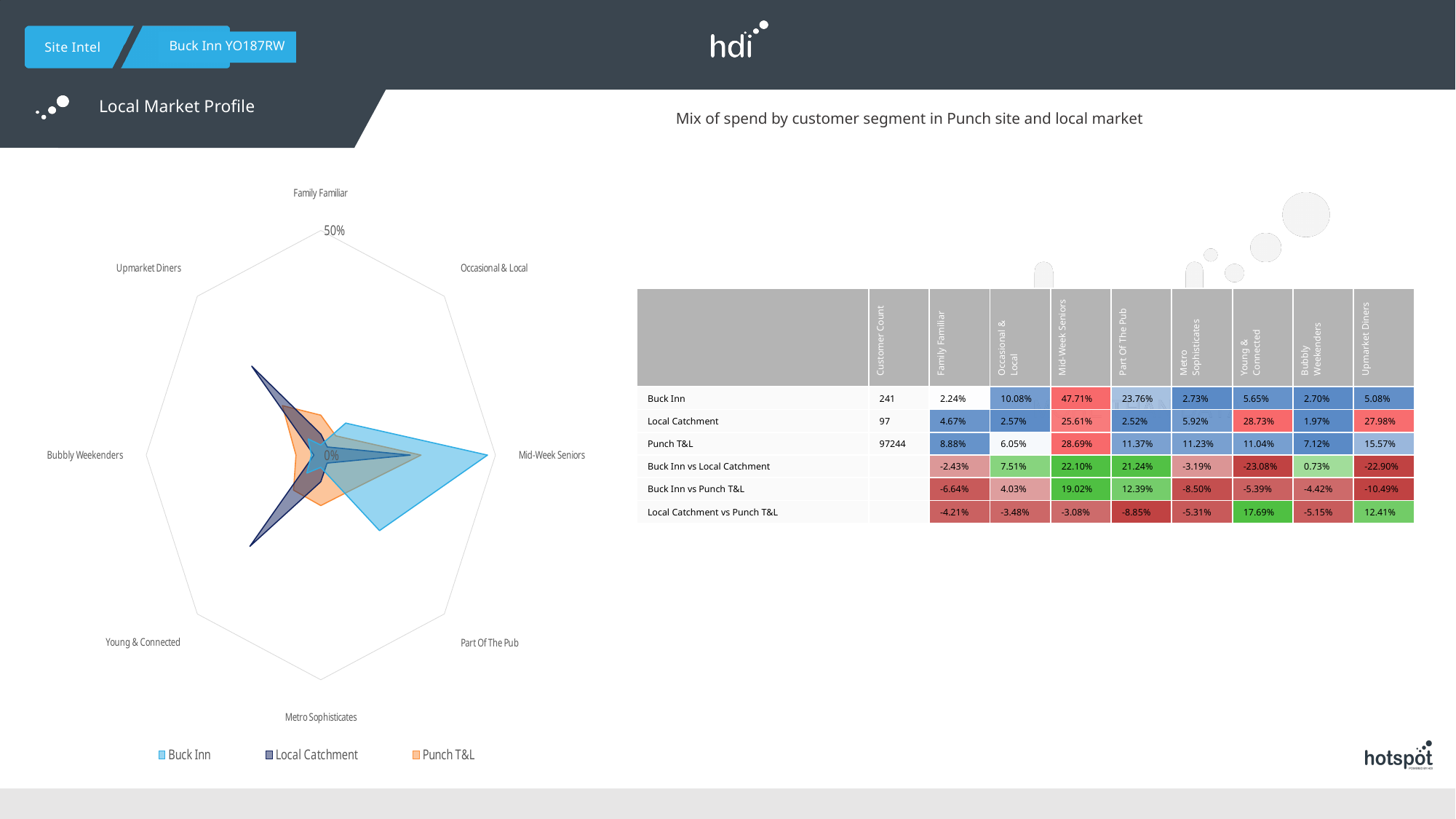
What is the difference between the Buck Inn and Local Catchment values for Mid-Week Seniors? 22.10% What type of chart is shown on the left of the slide? Radar chart What is the Punch T&L value for Part Of The Pub? 11.37% How many customer segments are plotted on the radar chart? 8 For Mid-Week Seniors, which is larger: Buck Inn or Local Catchment? Buck Inn How many series does the legend of the radar chart list? 3 Which customer segment has the highest value for Buck Inn on the radar chart? Mid-Week Seniors What is the maximum value labelled on the radar chart's axis? 50% On the radar chart, is the Punch T&L value for Mid-Week Seniors greater or less than 50%? less What is the Local Catchment value for Young & Connected? 28.73% Which customer segment has the highest value for Punch T&L? Mid-Week Seniors What is the Buck Inn value for Mid-Week Seniors? 47.71%